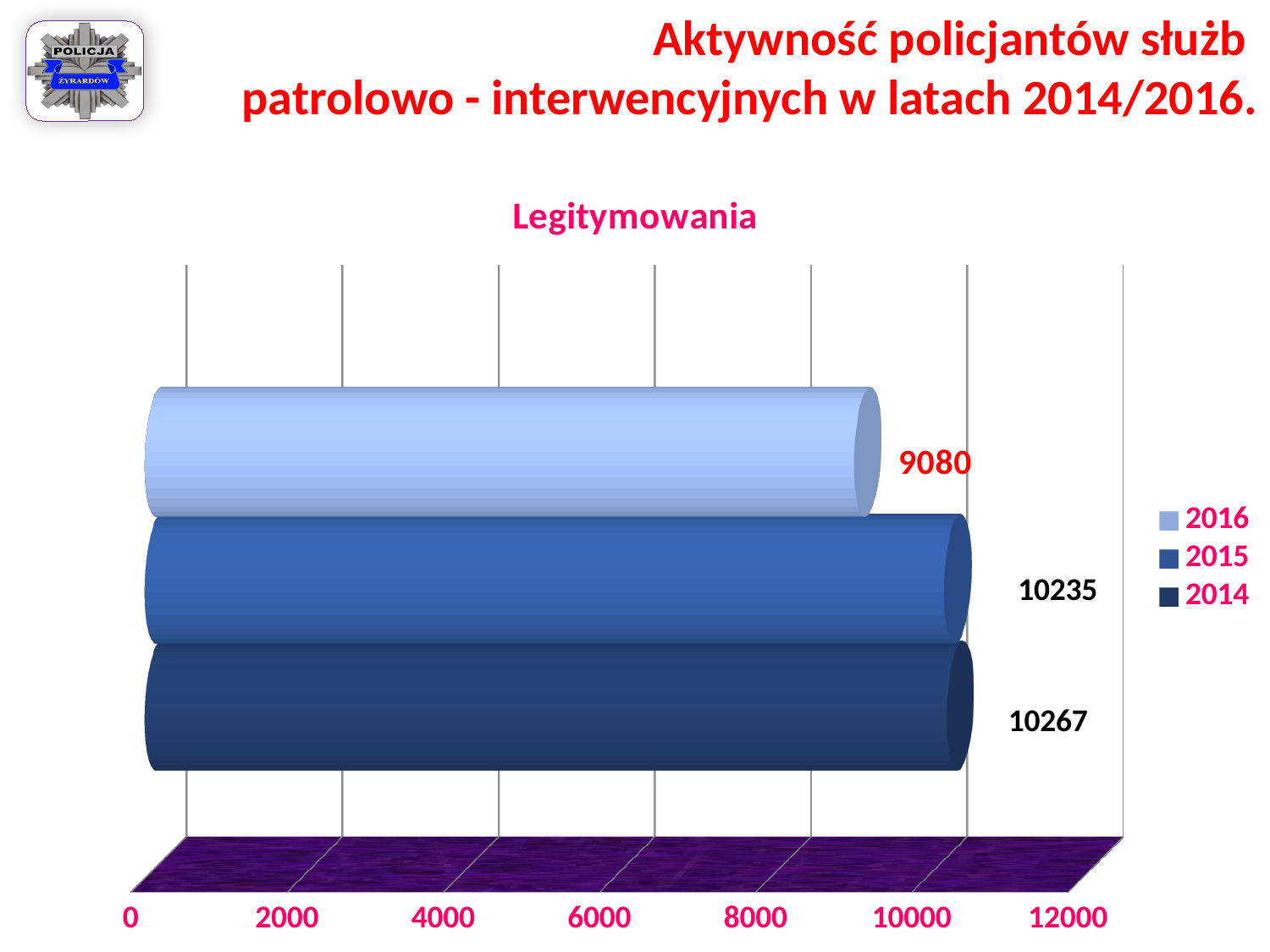
What is the value for 2016 in the Legitymowania chart? 9080 What is the value for 2015 in the Legitymowania chart? 10235 What kind of chart is the Legitymowania chart? bar chart What is the title of the chart on the slide? Legitymowania Which is larger in the Legitymowania chart, the value for 2015 or the value for 2016? 2015 Which year has the lowest value in the Legitymowania chart? 2016 What is the value for 2014 in the Legitymowania chart? 10267 What is the difference between the 2015 and 2016 values in the Legitymowania chart? 1155 Is the value for 2016 in the Legitymowania chart greater or less than 10000? less What is the difference between the 2014 and 2016 values in the Legitymowania chart? 1187 How many series does the legend of the Legitymowania chart list? 3 Is the value for 2014 in the Legitymowania chart greater or less than 10000? greater